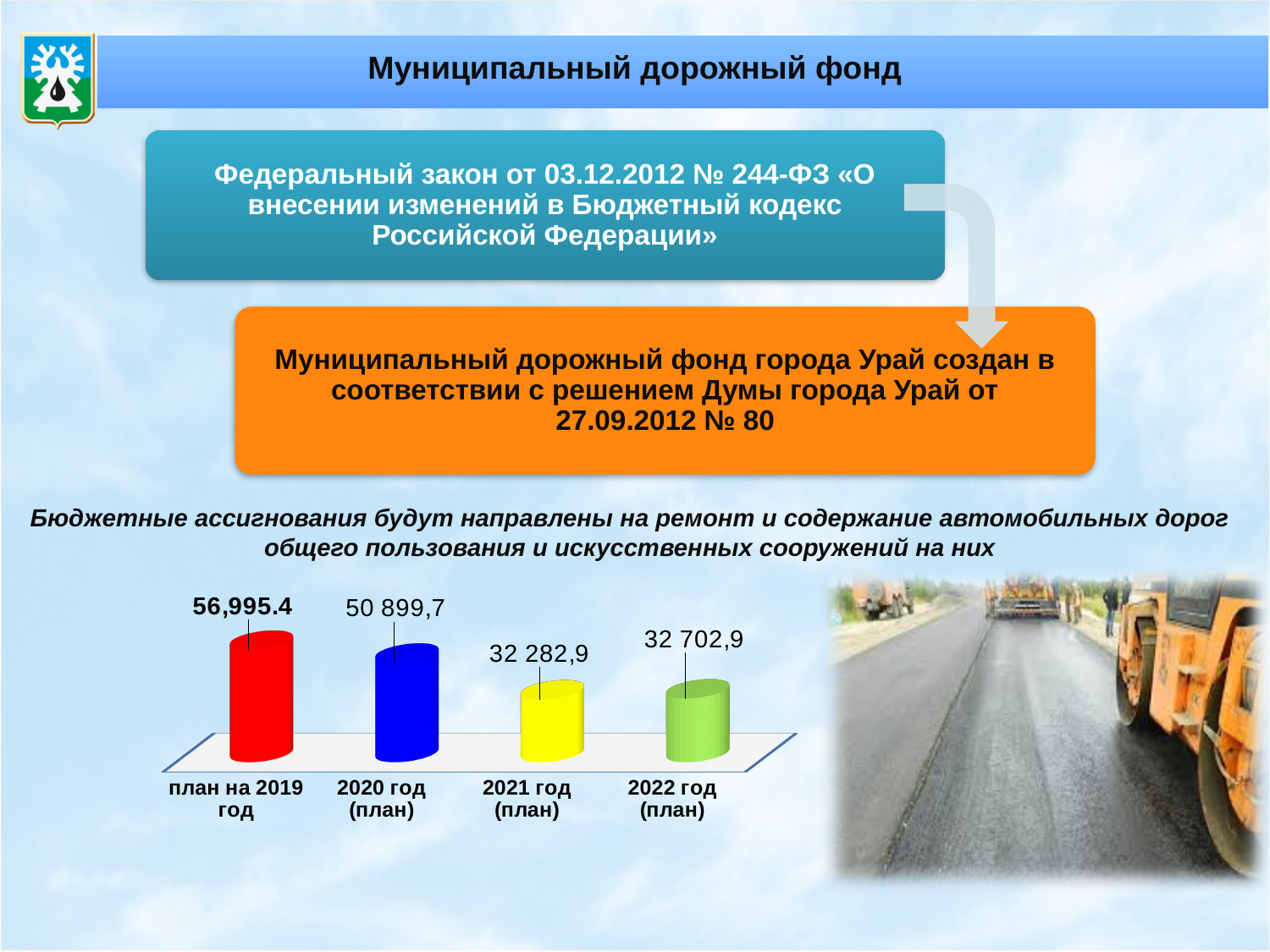
Which category has the lowest value in the chart? 2021 год (план) Do the values rise or fall from 'план на 2019 год' to '2021 год (план)'? fall What is the value shown for '2020 год (план)'? 50 899,7 What is the value shown for '2021 год (план)'? 32 282,9 What colour is the bar for 'план на 2019 год'? red What kind of chart is shown on the slide? bar chart What is the difference between the values for '2022 год (план)' and '2021 год (план)'? 420,0 Which is larger, the value for '2021 год (план)' or for '2022 год (план)'? 2022 год (план) How many categories are shown in the chart? 4 Which category has the highest value in the chart? план на 2019 год What is the value shown for '2022 год (план)'? 32 702,9 What is the value shown for 'план на 2019 год'? 56,995.4